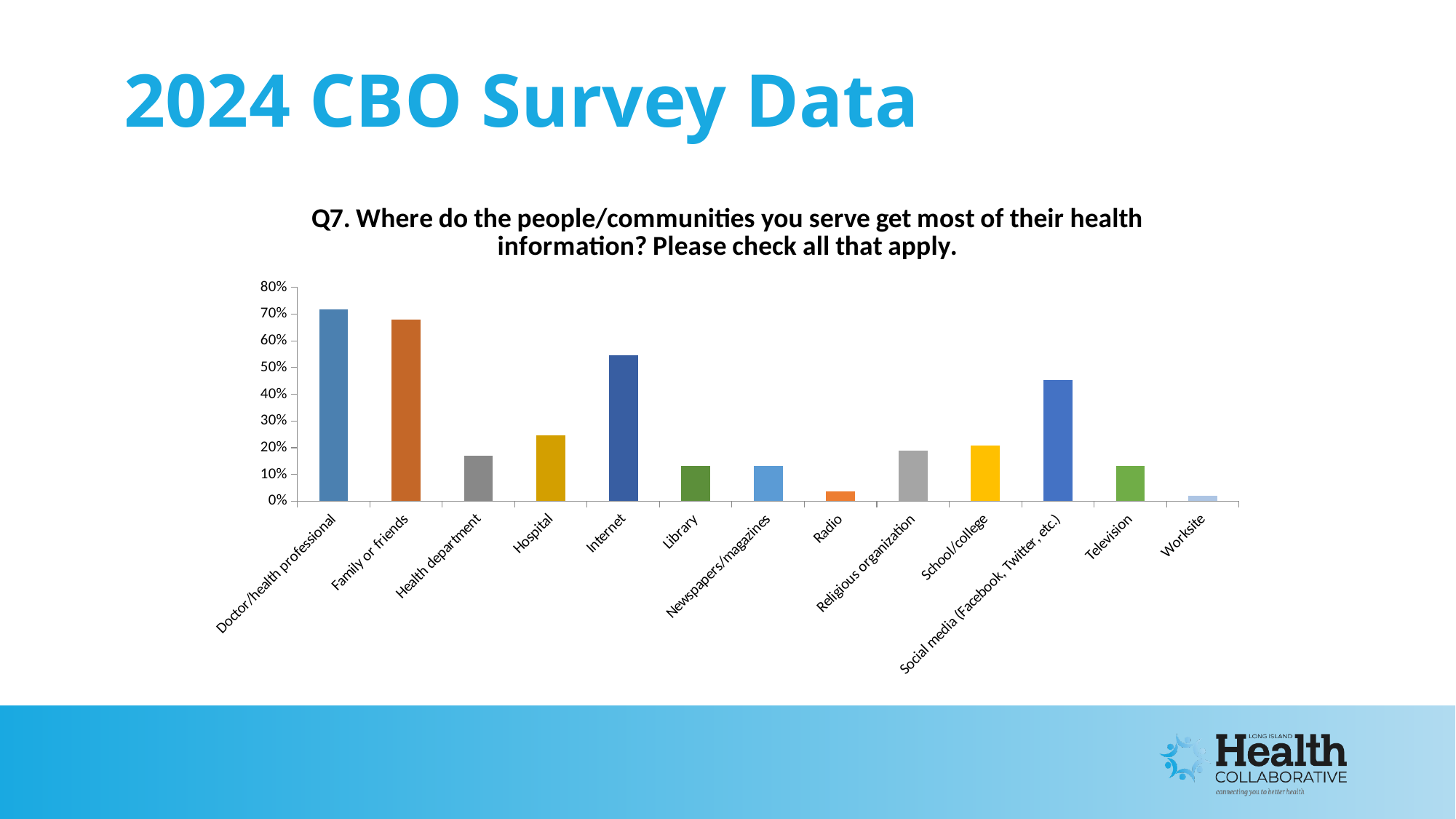
Which category has the highest value in the chart? Doctor/health professional What is the title of the chart? Q7. Where do the people/communities you serve get most of their health information? Please check all that apply. Is the value for Internet greater or less than 50%? greater Is the value for Social media (Facebook, Twitter, etc.) greater or less than 50%? less Which is larger, the value for Hospital or the value for Health department? Hospital How many categories (information sources) are shown on the x axis of the chart? 13 Which is larger, the value for Library or the value for Radio? Library Is the value for Family or friends greater or less than 60%? greater Which is larger, the value for Internet or the value for Social media (Facebook, Twitter, etc.)? Internet What kind of chart is shown on the slide? Bar chart